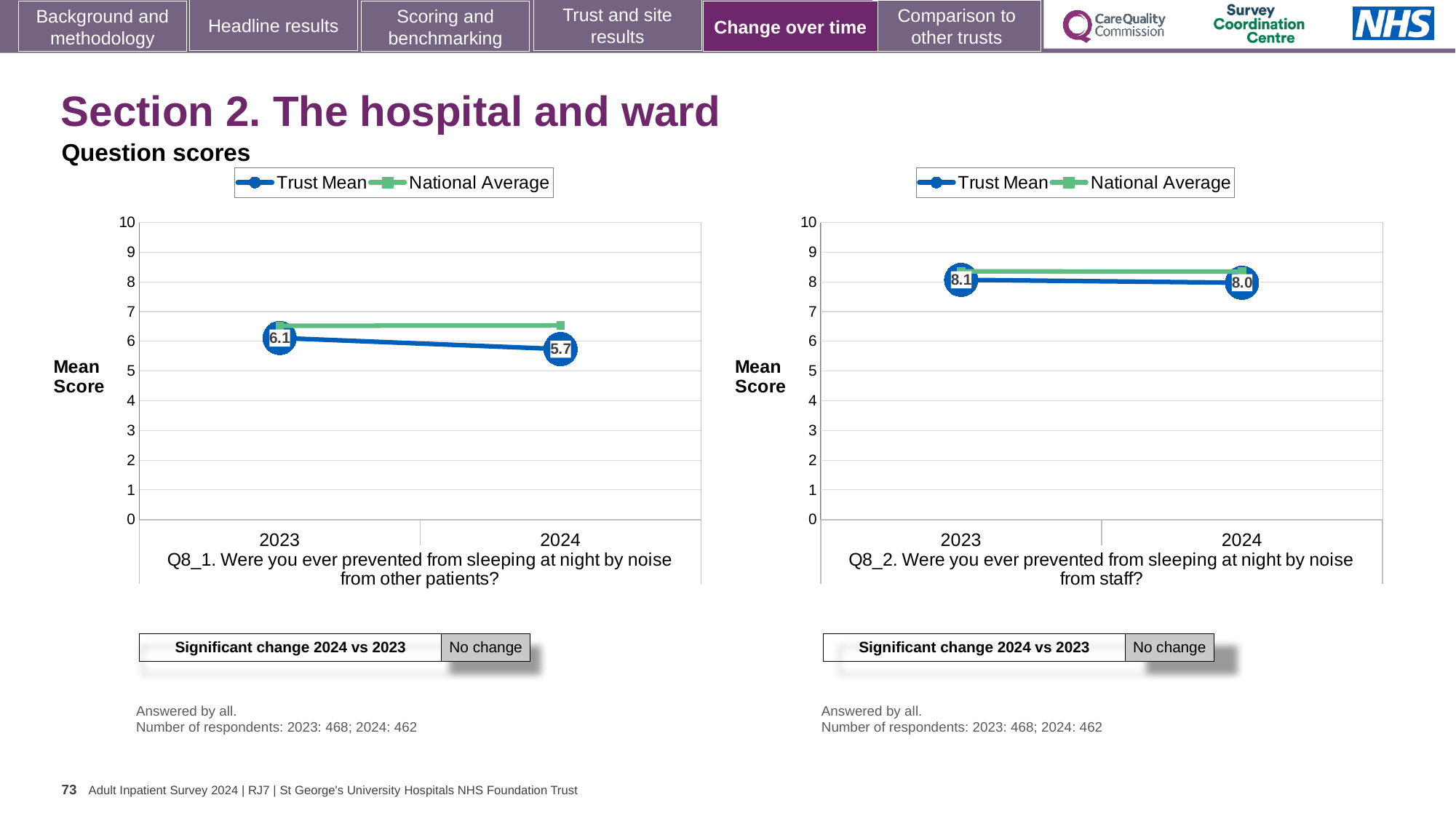
How many series does the legend of the Q8_2 chart (right) list? 2 In the Q8_1 chart (left), by how much did the Trust Mean change from 2023 to 2024? 0.4 In the Q8_2 chart (right), what is the difference between the Trust Mean for 2023 and 2024? 0.1 In the Q8_1 chart (left), is the National Average for 2024 greater or less than 6? greater In the Q8_1 chart (left), what is the Trust Mean score for 2023? 6.1 In the Q8_2 chart (right), what is the Trust Mean score for 2024? 8.0 In the Q8_1 chart (left), what is the Trust Mean score for 2024? 5.7 In the Q8_1 chart (left), does the Trust Mean rise or fall from 2023 to 2024? fall What type of chart is the Q8_1 chart (left)? line chart In the Q8_2 chart (right), what is the Trust Mean score for 2023? 8.1 In the Q8_2 chart (right), is the National Average for 2023 greater or less than 7? greater In the Q8_1 chart (left), which is higher in 2024, the Trust Mean or the National Average? National Average